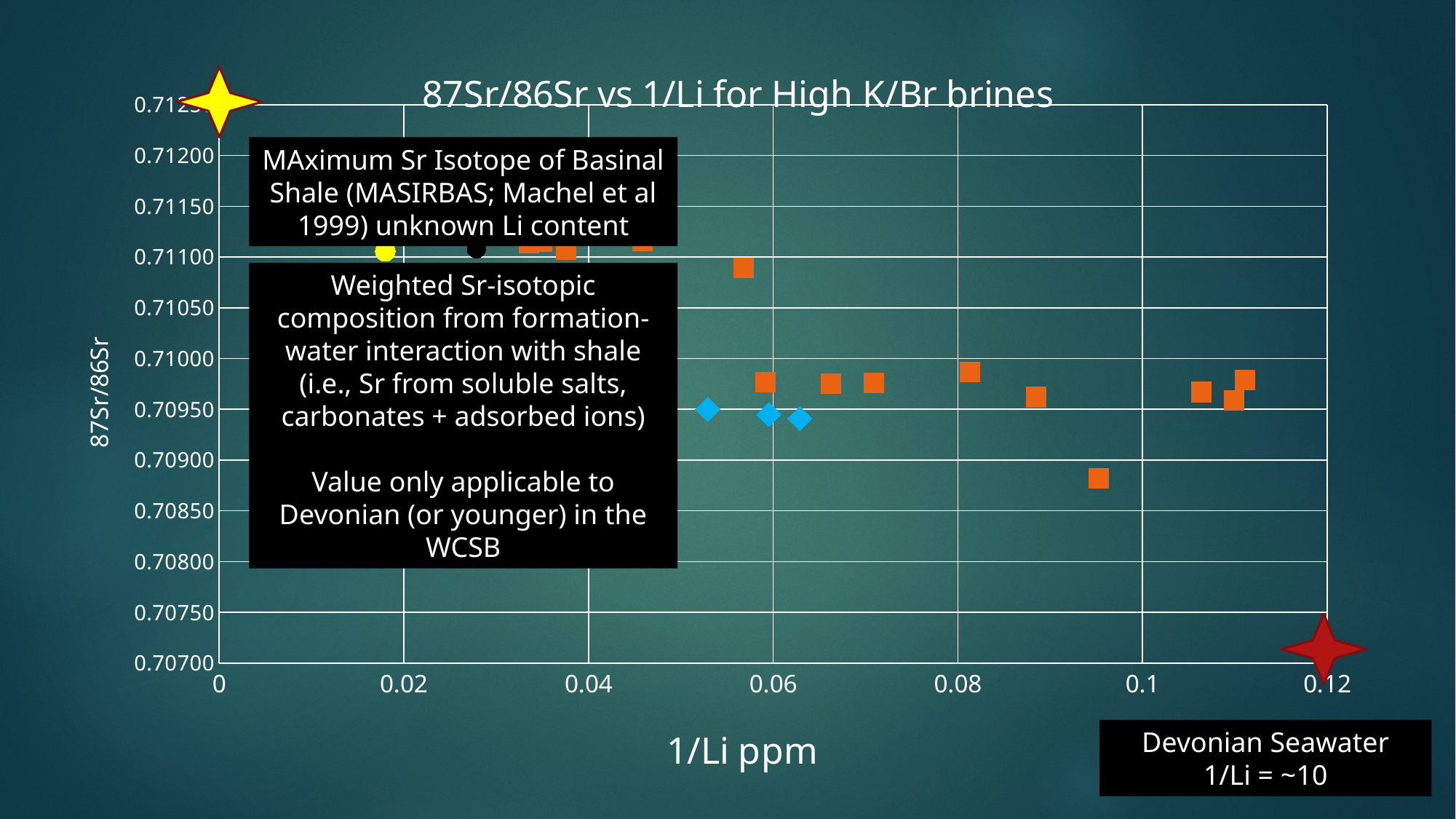
Which has the higher 87Sr/86Sr value: the orange square near 1/Li = 0.057 or the blue diamond near 1/Li = 0.06? the orange square near 0.057 Is the 87Sr/86Sr value of the orange square plotted near 1/Li = 0.081 greater or less than 0.70950? greater Is the 87Sr/86Sr value of the orange square plotted near 1/Li = 0.057 greater or less than 0.71100? less What kind of chart is shown on the slide? scatter chart Which has the higher 87Sr/86Sr value: the orange square near 1/Li = 0.081 or the orange square near 1/Li = 0.095? the one near 0.081 What is the title of the chart? 87Sr/86Sr vs 1/Li for High K/Br brines What is the label of the x axis? 1/Li ppm Is the 87Sr/86Sr value of the orange square plotted near 1/Li = 0.095 greater or less than 0.70900? less Among the orange squares, which one has the lowest 87Sr/86Sr value? the one near 1/Li = 0.095